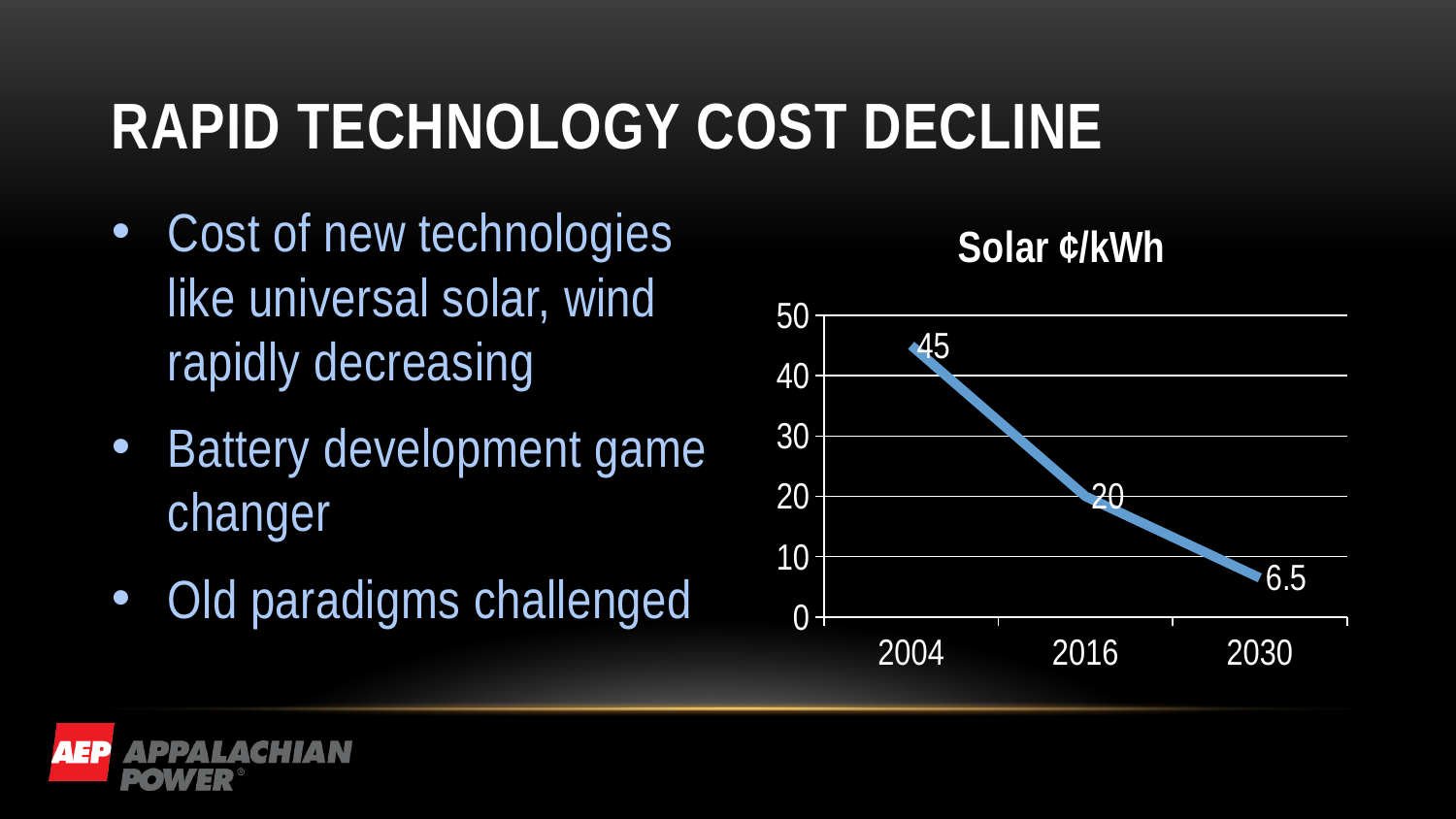
Do the values rise or fall from 2004 to 2030? fall How many years are plotted on the chart? 3 What kind of chart is shown on the slide? line chart What is the solar cost in ¢/kWh for 2004? 45 What is the difference between the solar cost in 2004 and in 2016? 25 What is the solar cost in ¢/kWh for 2016? 20 Which year has the highest solar cost? 2004 What is the solar cost in ¢/kWh for 2030? 6.5 What is the title of the chart? Solar ¢/kWh Which year has the lowest solar cost? 2030 What is the difference between the solar cost in 2016 and in 2030? 13.5 Which year has a larger solar cost, 2016 or 2030? 2016